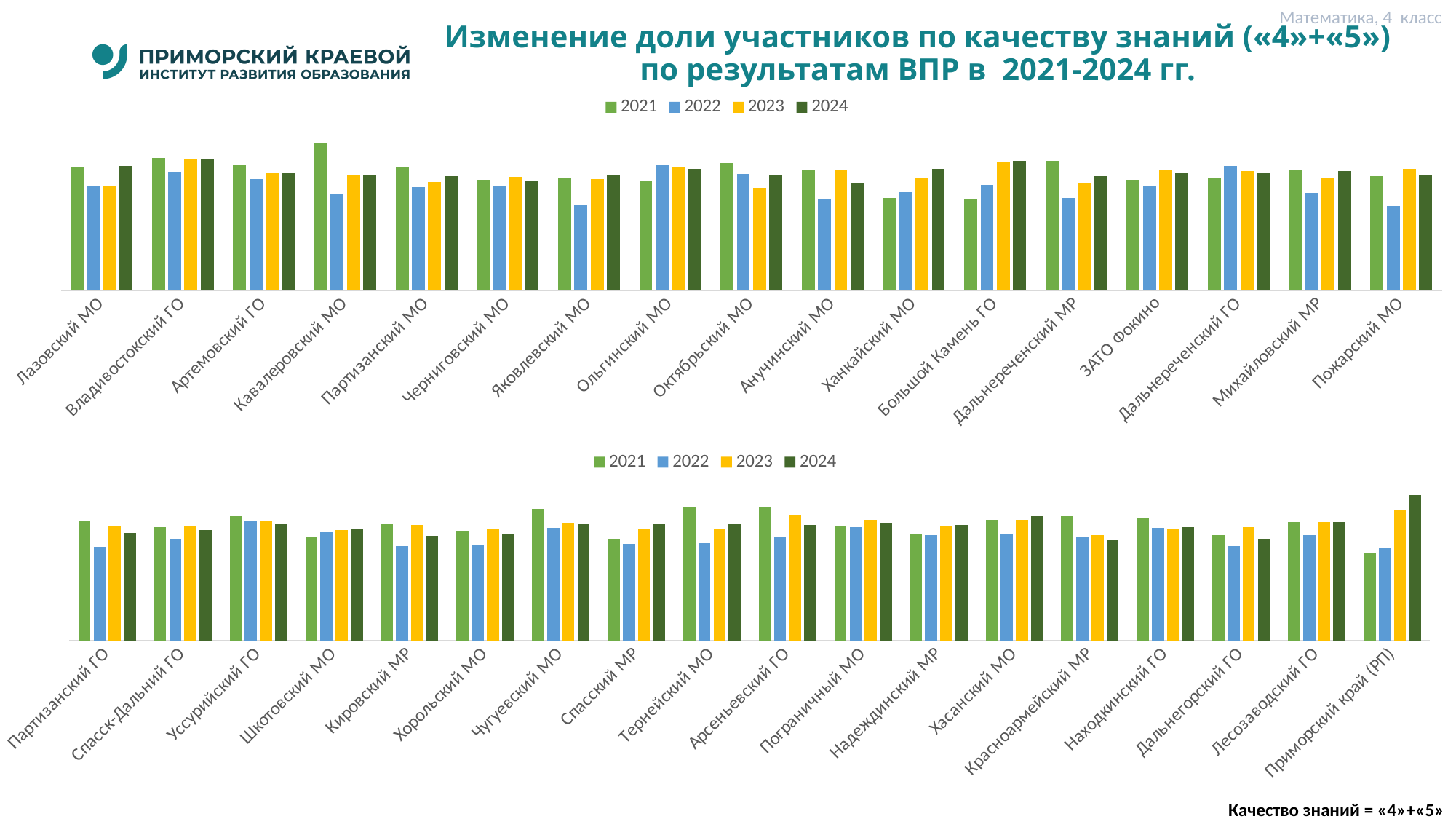
In the top chart, which year has the shortest bar for Большой Камень ГО? 2021 How many categories (municipalities) are shown on the x axis of the bottom chart? 18 In the bottom chart, for Приморский край (РП), is the 2021 bar or the 2024 bar taller? 2024 In the top chart, for Яковлевский МО, is the 2022 bar or the 2024 bar taller? 2024 In the bottom chart, which year has the tallest bar for Приморский край (РП)? 2024 How many series does the legend of the top chart list? 4 How many categories (municipalities) are shown on the x axis of the top chart? 17 In the top chart, which year has the shortest bar for Кавалеровский МО? 2022 Which colour represents the 2023 series in the legend? yellow What kind of chart is the top chart on the slide? bar chart In the top chart, which year has the tallest bar for Кавалеровский МО? 2021 In the bottom chart, do the bars for Приморский край (РП) rise or fall from 2021 to 2024? rise